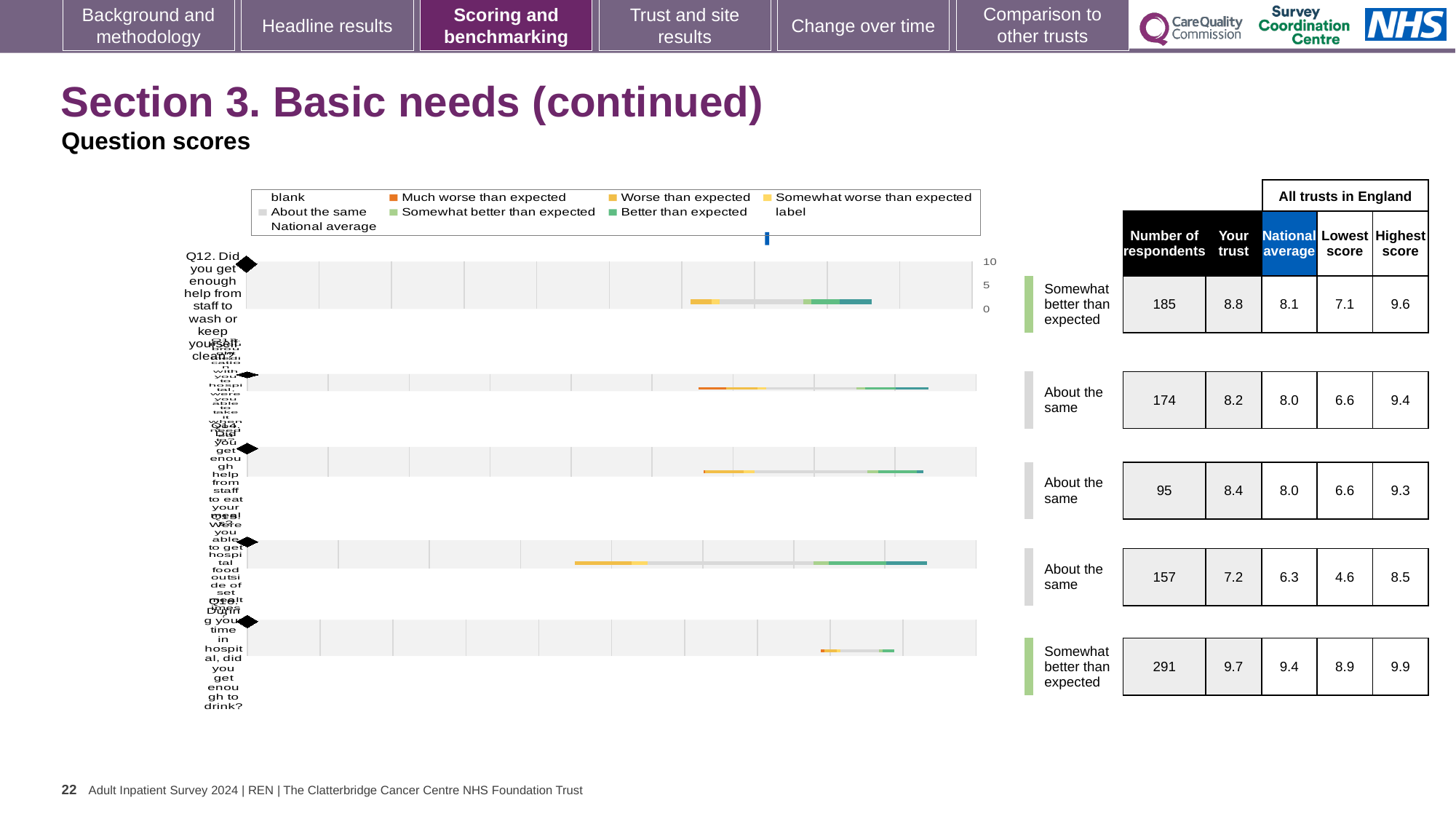
Which benchmark category is shown for Q12 (help from staff to wash or keep yourself clean)? Somewhat better than expected How many respondents are listed for the fifth (bottom) row of the chart? 291 What is the highest score among all trusts in England for Q12? 9.6 Which row of the chart has the lowest 'Your trust' score? The fourth row, 7.2 What is the national average score for Q12 (help from staff to wash or keep yourself clean)? 8.1 How many survey questions are plotted as rows in the chart? 5 Which row of the chart has the highest 'Your trust' score? The fifth (bottom) row, 9.7 What is the 'Your trust' score for Q12 (help from staff to wash or keep yourself clean)? 8.8 Is the 'Your trust' marker for Q12 greater or less than 5 on the chart axis? greater For the fourth row of the chart, which is larger: the 'Your trust' score or the national average? Your trust (7.2) What is the lowest score among all trusts in England for the fourth row of the chart? 4.6 By how much does the 'Your trust' score for Q12 exceed the national average? 0.7